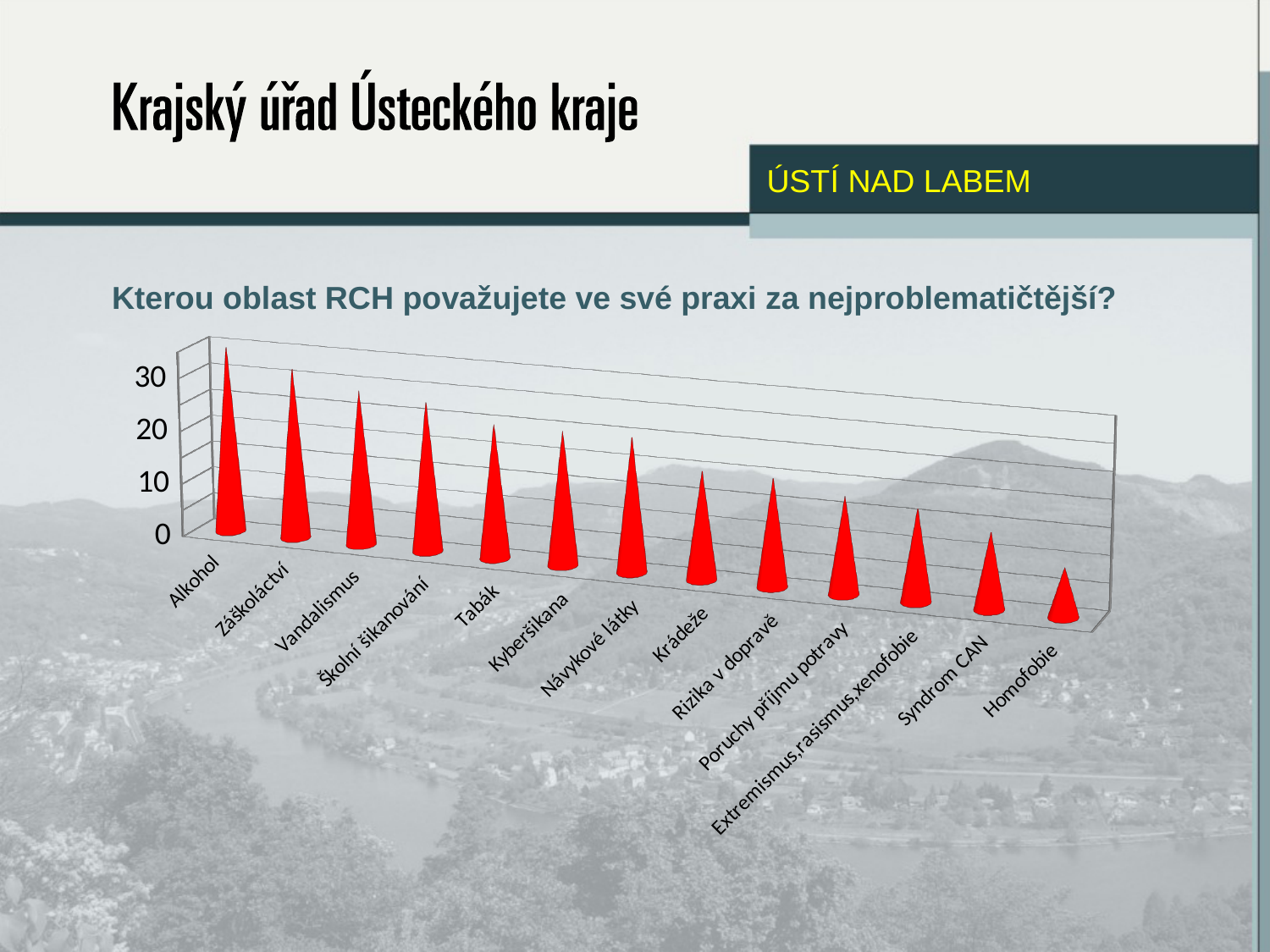
Which category has the lowest value? Homofobie Which is larger, the value for Homofobie or the value for Tabák? Tabák How many categories are plotted on the chart? 13 Do the values rise or fall moving from left to right along the x axis? fall What kind of chart is shown on the slide? bar chart What colour are the bars in the chart? red Is the value for Záškoláctví greater or less than 20? greater What is the title of the chart? Kterou oblast RCH považujete ve své praxi za nejproblematičtější? Which category has the highest value? Alkohol Is the value for Alkohol greater or less than 30? greater Is the value for Syndrom CAN greater or less than 20? less Which is larger, the value for Vandalismus or the value for Krádeže? Vandalismus